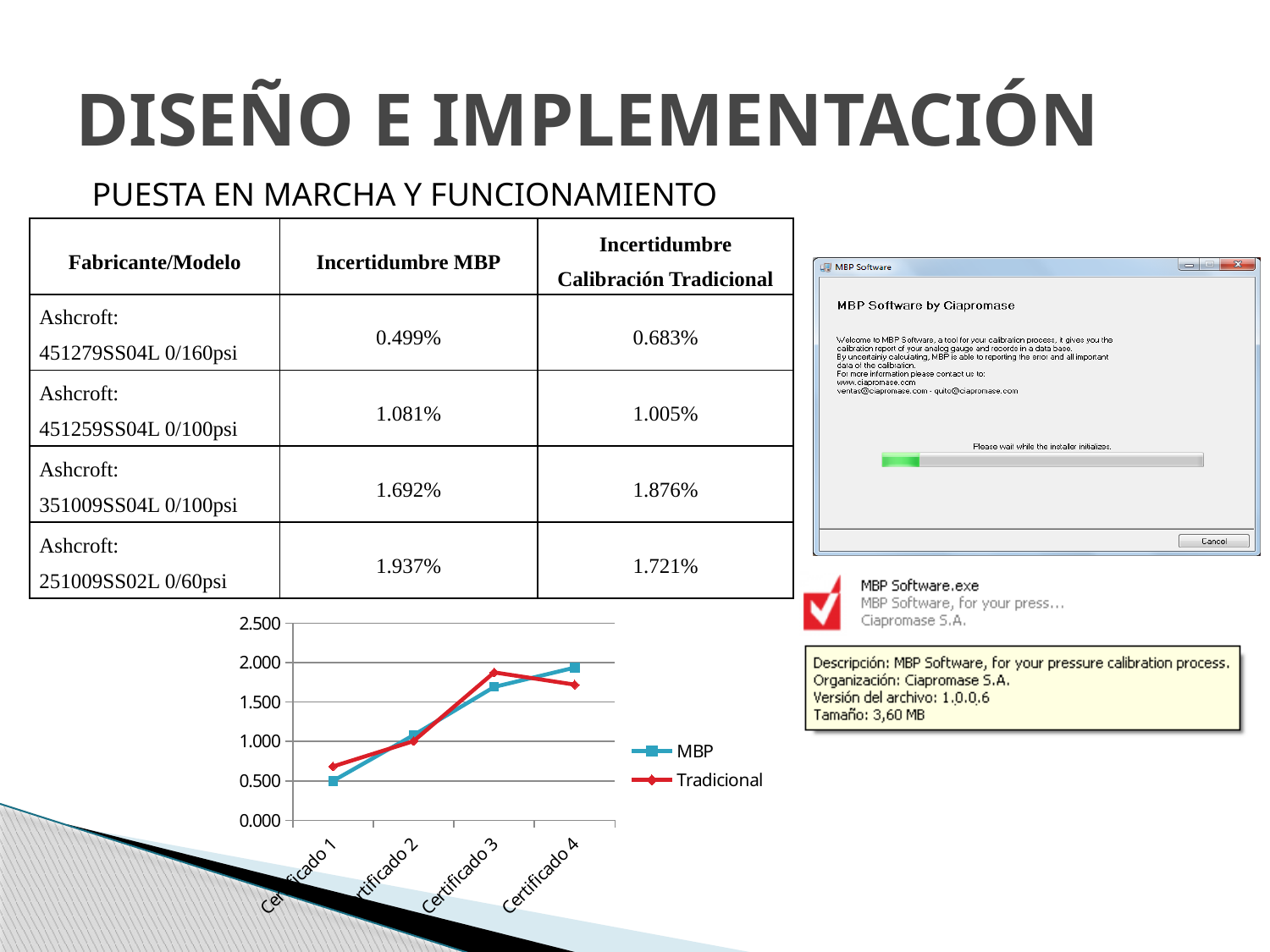
At Certificado 4, which series has the higher value, MBP or Tradicional? MBP Is the MBP value for Certificado 1 greater or less than 1.000? less For the MBP series, which category has the highest value? Certificado 4 Which series is drawn in red in the chart? Tradicional For the Tradicional series, which category has the lowest value? Certificado 1 How many categories are plotted along the x axis of the chart? 4 At Certificado 3, which series has the higher value, MBP or Tradicional? Tradicional Is the MBP value for Certificado 4 greater or less than 1.500? greater What kind of chart is shown on the slide? Line chart Is the Tradicional value for Certificado 1 greater or less than 1.000? less Does the MBP series rise or fall from Certificado 1 to Certificado 4? Rises How many series does the chart legend list? 2